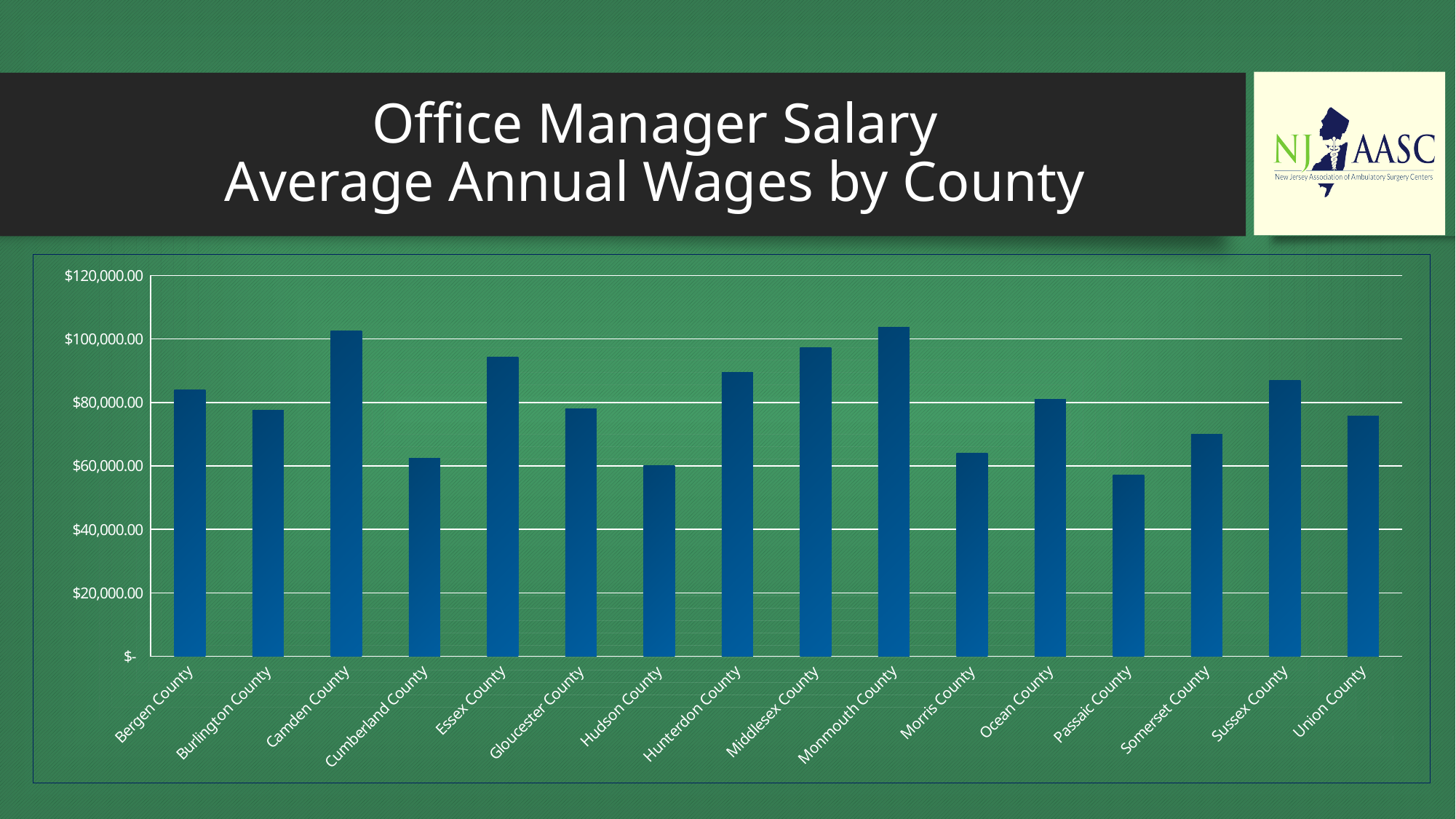
What kind of chart is shown on the slide? bar chart Is the value for Sussex County greater or less than $80,000.00? greater Which is larger, the value for Middlesex County or the value for Hunterdon County? Middlesex County Is the value for Camden County greater or less than $100,000.00? greater How many counties are shown on the x axis of the chart? 16 What is the title of the slide containing the chart? Office Manager Salary Average Annual Wages by County Is the value for Morris County greater or less than $80,000.00? less Which county has the lowest average annual wage in the chart? Passaic County Which is larger, the value for Ocean County or the value for Morris County? Ocean County Which is larger, the value for Essex County or the value for Bergen County? Essex County